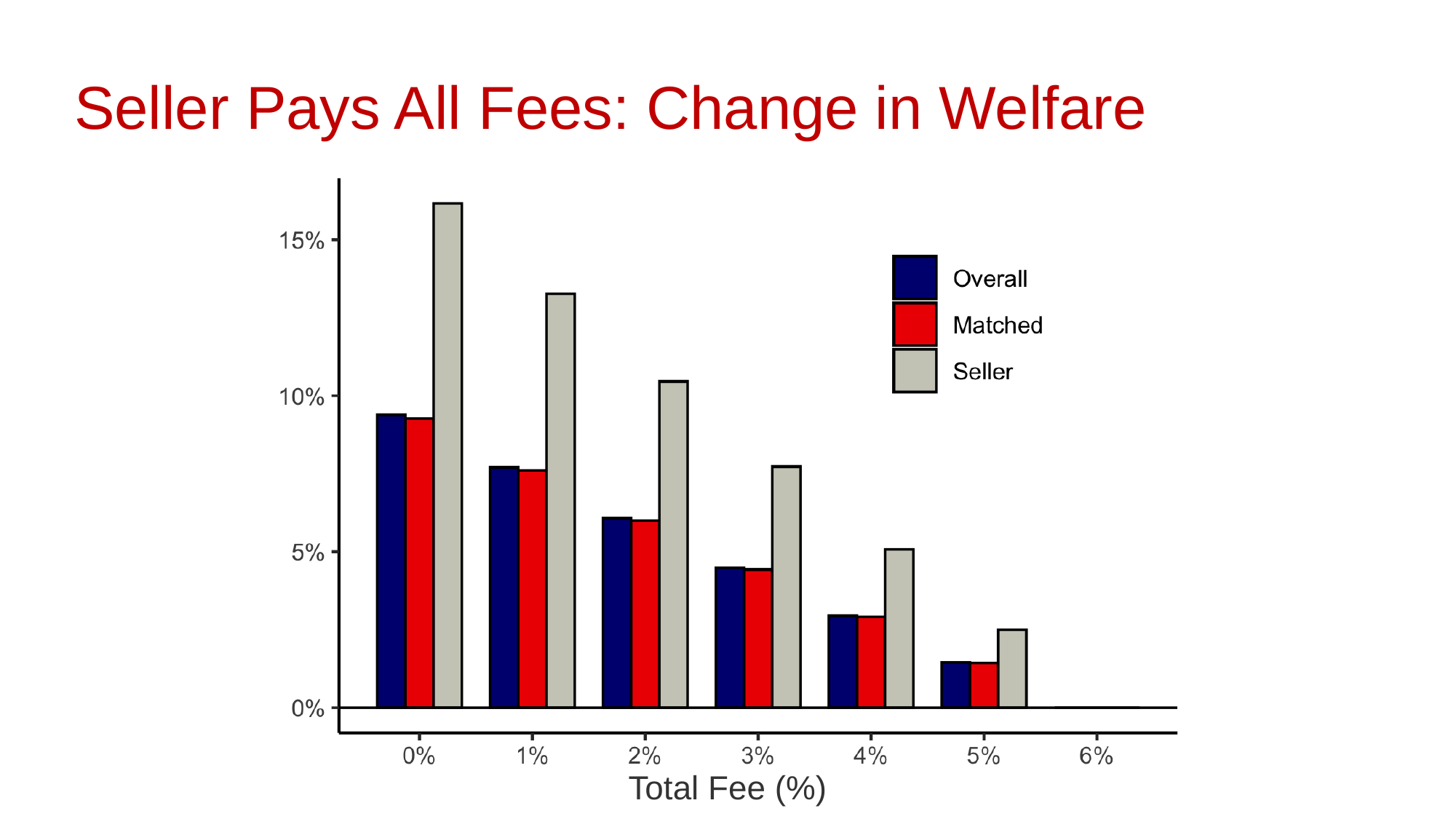
Is the Matched value at a 3% total fee greater or less than 5%? less How many Total Fee categories are labelled on the x axis? 7 Is the Seller value at a 2% total fee greater or less than 10%? greater Is the Seller value at a 0% total fee greater or less than 15%? greater At which total fee level is the Seller bar highest? 0% At a 3% total fee, which is larger, the Seller value or the Overall value? Seller Do the Seller values rise or fall as the total fee increases from 0% to 5%? fall Which series has the highest bar at a 1% total fee? Seller What kind of chart is shown on the slide? bar chart How many series does the legend list? 3